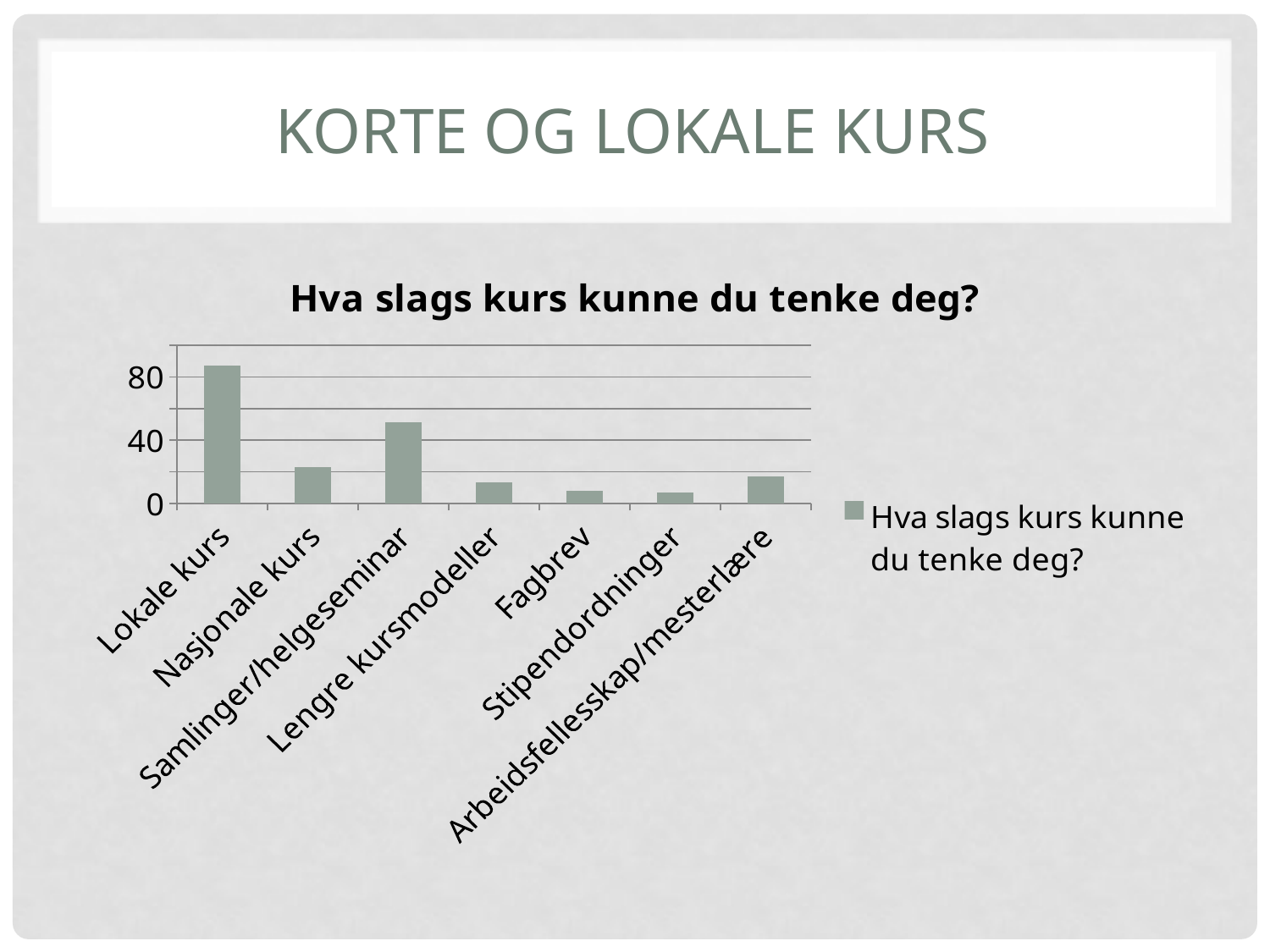
How many series does the chart's legend list? 1 Is the value for Samlinger/helgeseminar greater or less than 40? greater How many categories are shown on the x axis of the chart? 7 Which category has the highest value in the chart? Lokale kurs Which is larger, the value for Lokale kurs or the value for Samlinger/helgeseminar? Lokale kurs Which is larger, the value for Samlinger/helgeseminar or the value for Nasjonale kurs? Samlinger/helgeseminar Is the value for Nasjonale kurs greater or less than 40? less What is the title of the chart? Hva slags kurs kunne du tenke deg? What is the legend entry shown next to the chart? Hva slags kurs kunne du tenke deg? Is the value for Fagbrev greater or less than 40? less What kind of chart is shown on the slide? bar chart